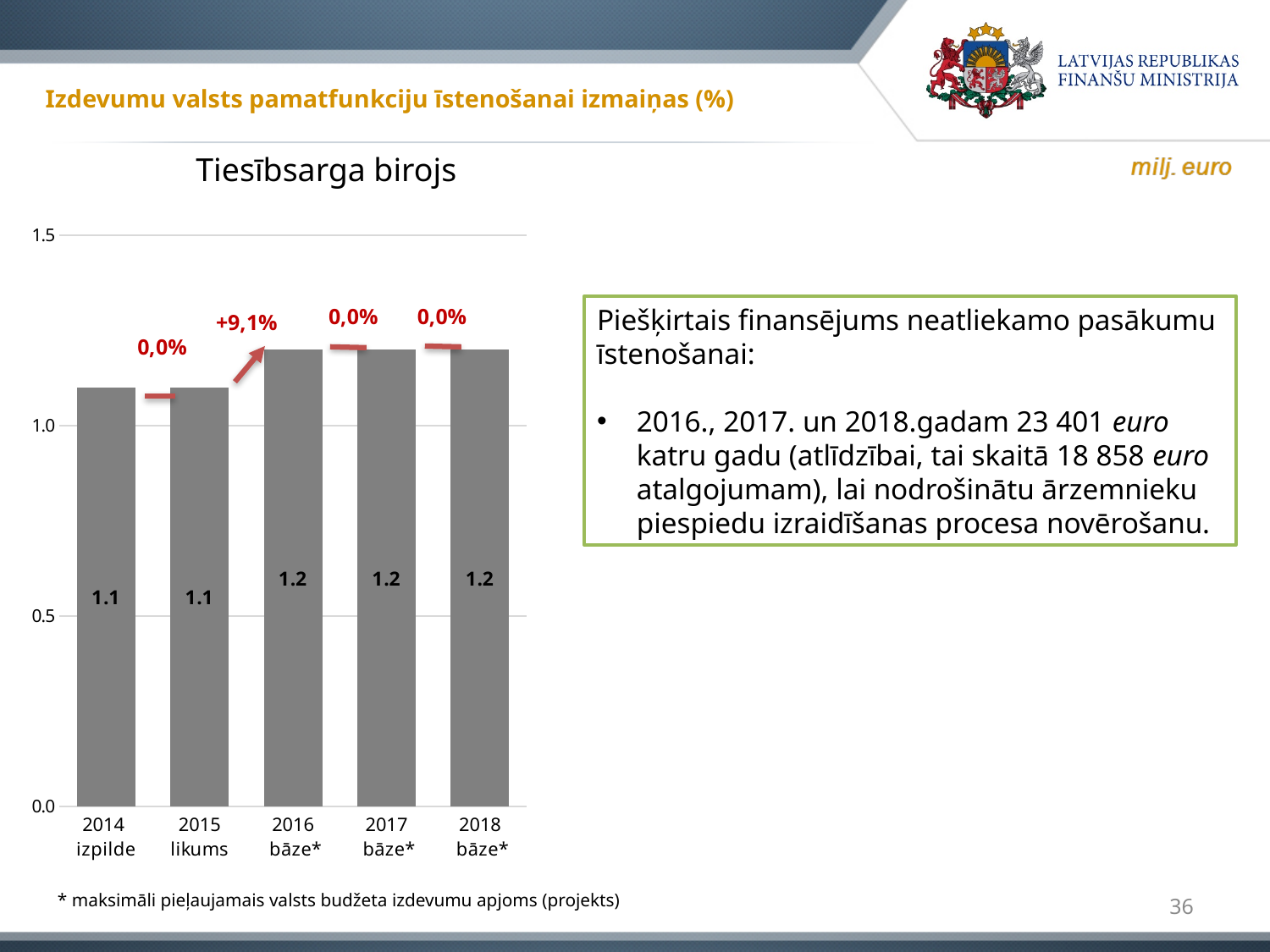
What percentage change is shown between 2015 likums and 2016 bāze*? +9,1% What is the value for 2018 bāze*? 1.2 Which is larger, the value for 2015 likums or the value for 2017 bāze*? 2017 bāze* What is the value for 2014 izpilde? 1.1 What is the title of the chart? Tiesībsarga birojs What kind of chart is shown on the slide? bar chart What is the value for 2016 bāze*? 1.2 How many bars are shown in the chart? 5 Is the value for 2016 bāze* greater or less than 1.0? greater What is the difference between the values for 2016 bāze* and 2014 izpilde? 0.1 Do the values rise or fall from 2015 likums to 2016 bāze*? rise What percentage change is shown between 2014 izpilde and 2015 likums? 0,0%